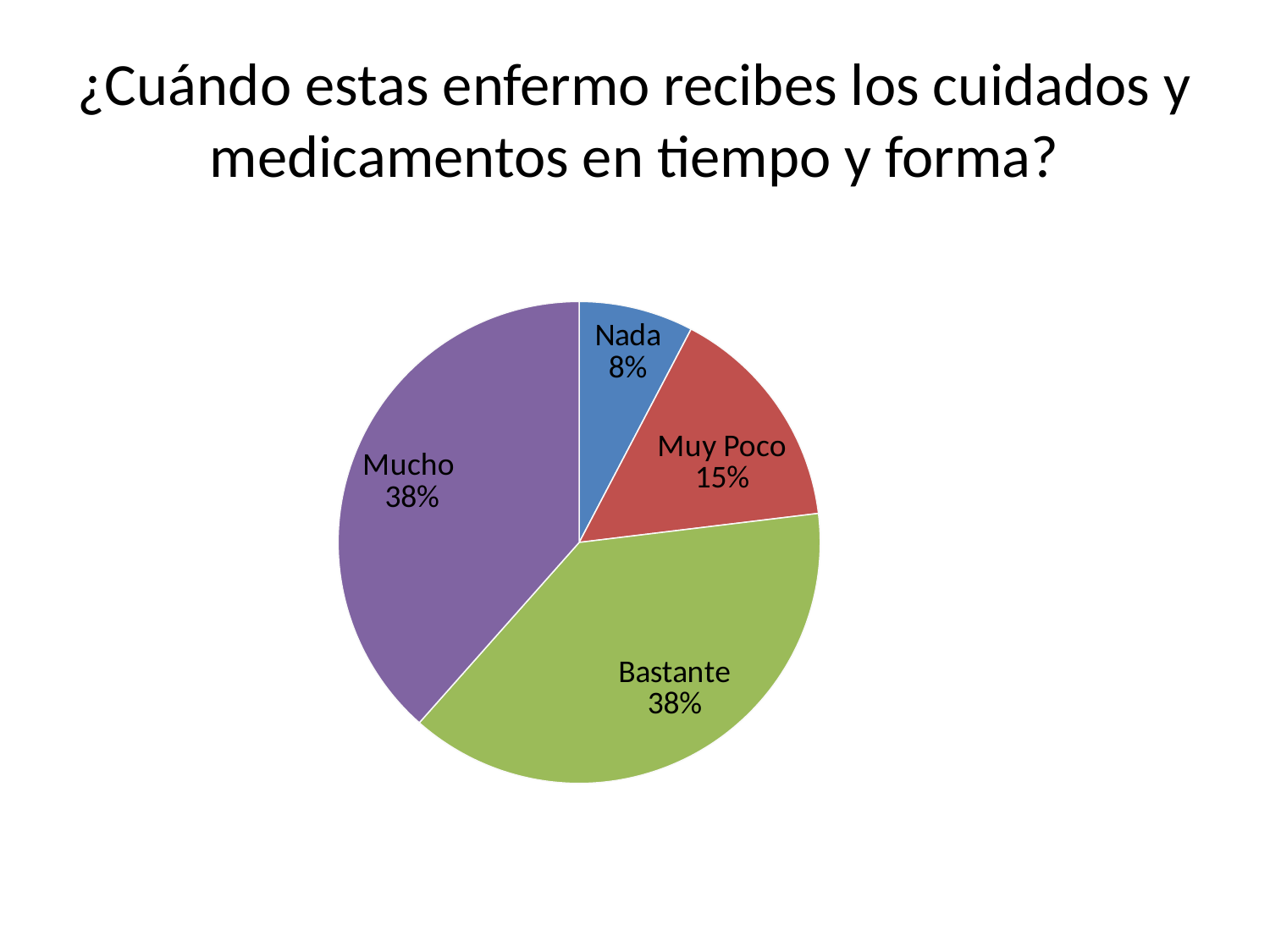
What colour is the "Mucho" slice of the pie chart? purple Which is larger, the "Muy Poco" slice or the "Bastante" slice? Bastante How many slices does the pie chart have? 4 What share of the pie does the "Nada" slice represent? 8% What share of the pie does the "Mucho" slice represent? 38% Which is larger, the "Nada" slice or the "Muy Poco" slice? Muy Poco What is the difference in percentage points between the "Bastante" slice and the "Muy Poco" slice? 23 Which category has the smallest slice of the pie? Nada What kind of chart is shown on the slide? pie chart What is the difference in percentage points between the "Mucho" slice and the "Nada" slice? 30 What share of the pie does the "Muy Poco" slice represent? 15%